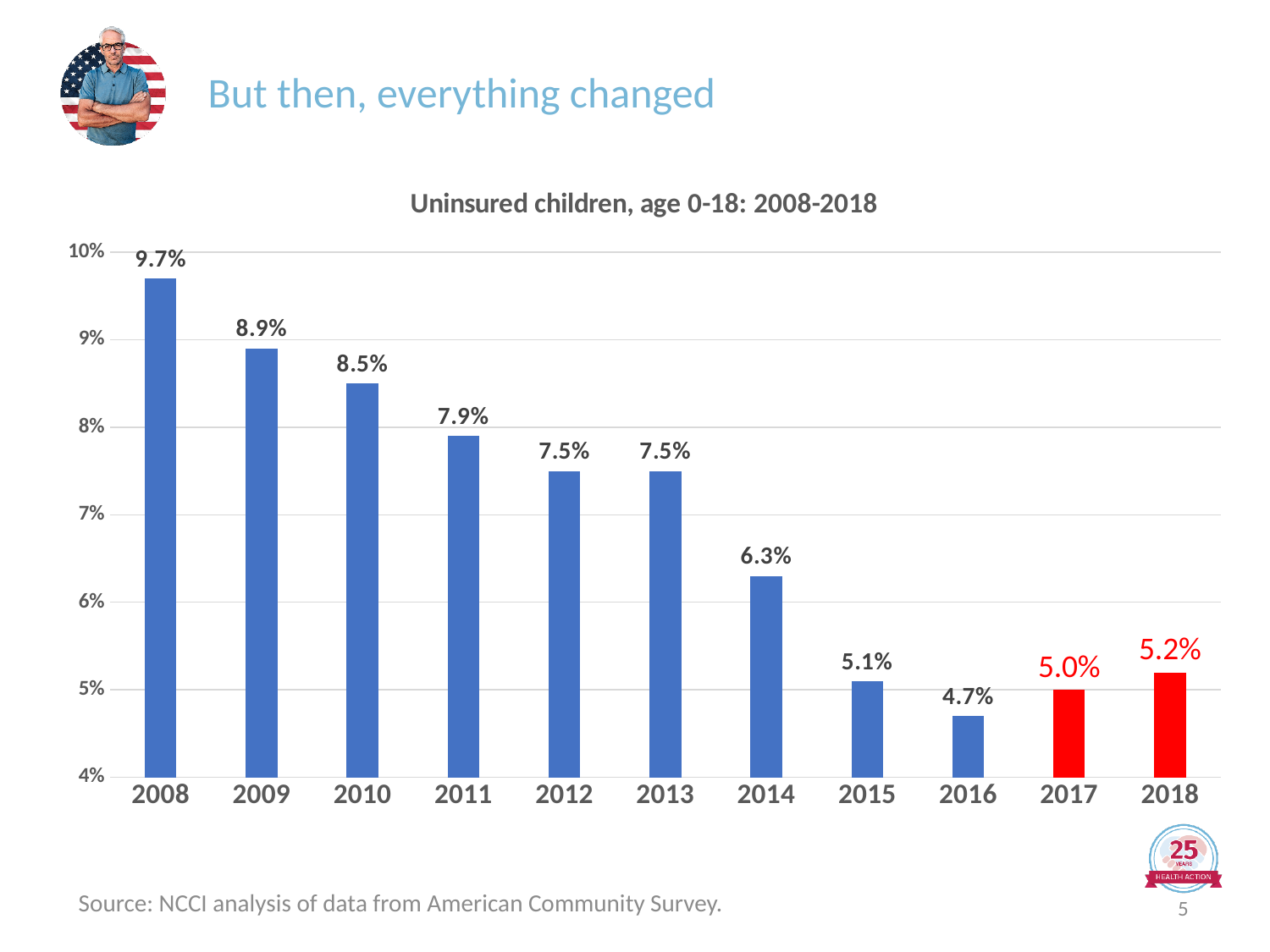
What is the uninsured rate for children in 2018? 5.2% Does the uninsured rate for children generally rise or fall from 2008 to 2016? Fall What is the difference between the uninsured rates in 2008 and 2018? 4.5% What is the uninsured rate for children in 2008? 9.7% Which year has the lowest uninsured rate for children? 2016 Which year has a higher uninsured rate, 2017 or 2018? 2018 What is the uninsured rate for children in 2016? 4.7% What kind of chart is shown on the slide? Bar chart How many years are shown on the chart? 11 Which year has the highest uninsured rate for children? 2008 What is the title of the chart? Uninsured children, age 0-18: 2008-2018 What is the difference between the uninsured rates in 2014 and 2015? 1.2%